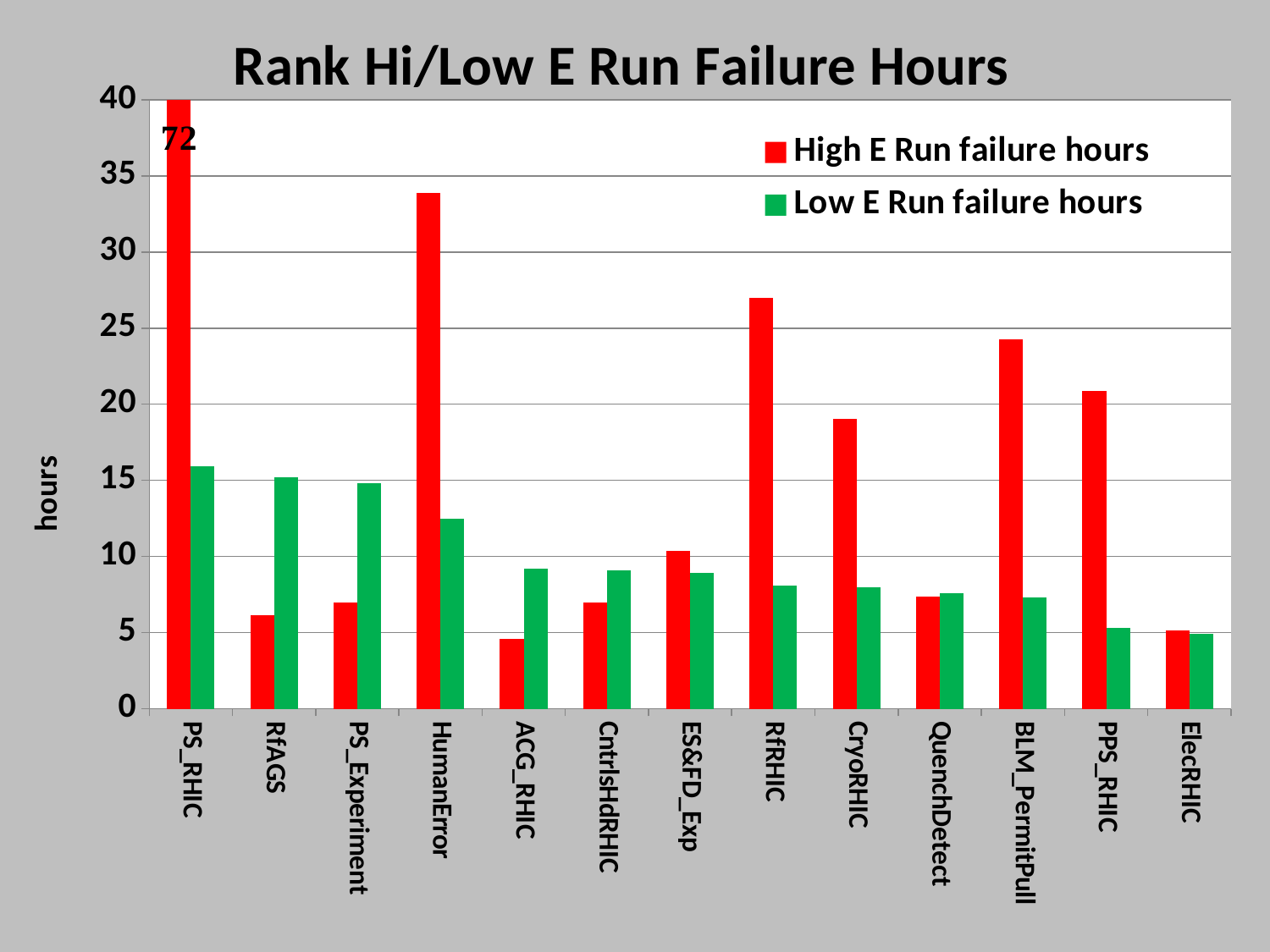
How many series does the legend list? 2 For HumanError, which is larger: High E Run failure hours or Low E Run failure hours? High E Run failure hours Is the High E Run failure hours value for RfAGS greater or less than 10? less Is the High E Run failure hours value for RfRHIC greater or less than 25? greater How many categories are shown on the x axis? 13 For RfAGS, which is larger: High E Run failure hours or Low E Run failure hours? Low E Run failure hours Is the High E Run failure hours value for BLM_PermitPull greater or less than 20? greater Which category has the highest High E Run failure hours? PS_RHIC What colour represents the High E Run failure hours series? red What is the High E Run failure hours value for PS_RHIC? 72 What kind of chart is shown on the slide? bar chart